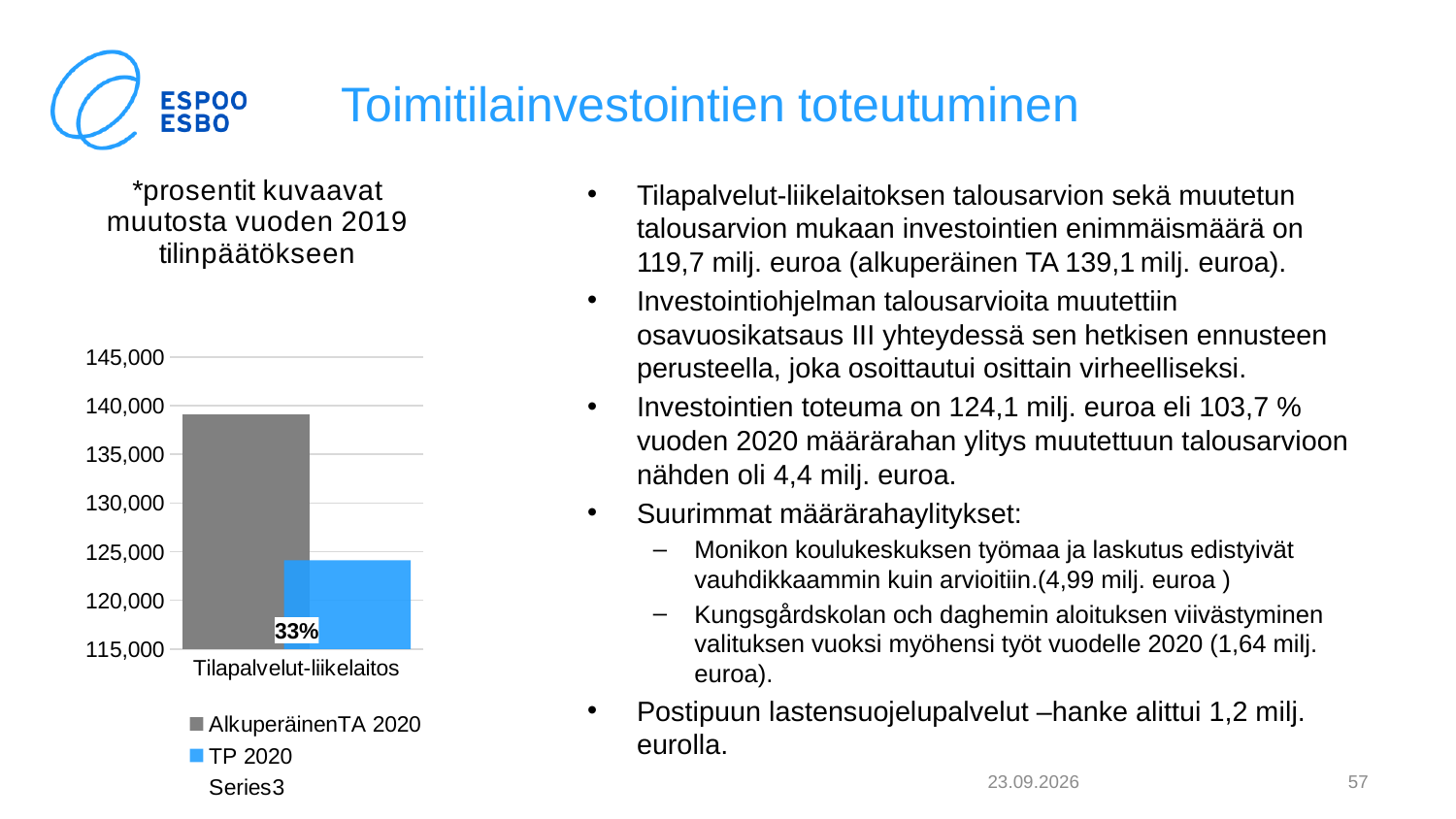
How many categories are shown on the x axis of the chart? 1 Is the value for TP 2020 greater or less than 125,000? less What is the highest value shown on the chart's vertical axis? 145,000 What is the category label on the x axis of the chart? Tilapalvelut-liikelaitos Is the value for TP 2020 greater or less than 120,000? greater What percentage data label is printed on the chart? 33% Is the value for AlkuperäinenTA 2020 greater or less than 140,000? less What kind of chart is shown on the slide? bar chart How many series does the chart legend list? 3 Which is larger for Tilapalvelut-liikelaitos, AlkuperäinenTA 2020 or TP 2020? AlkuperäinenTA 2020